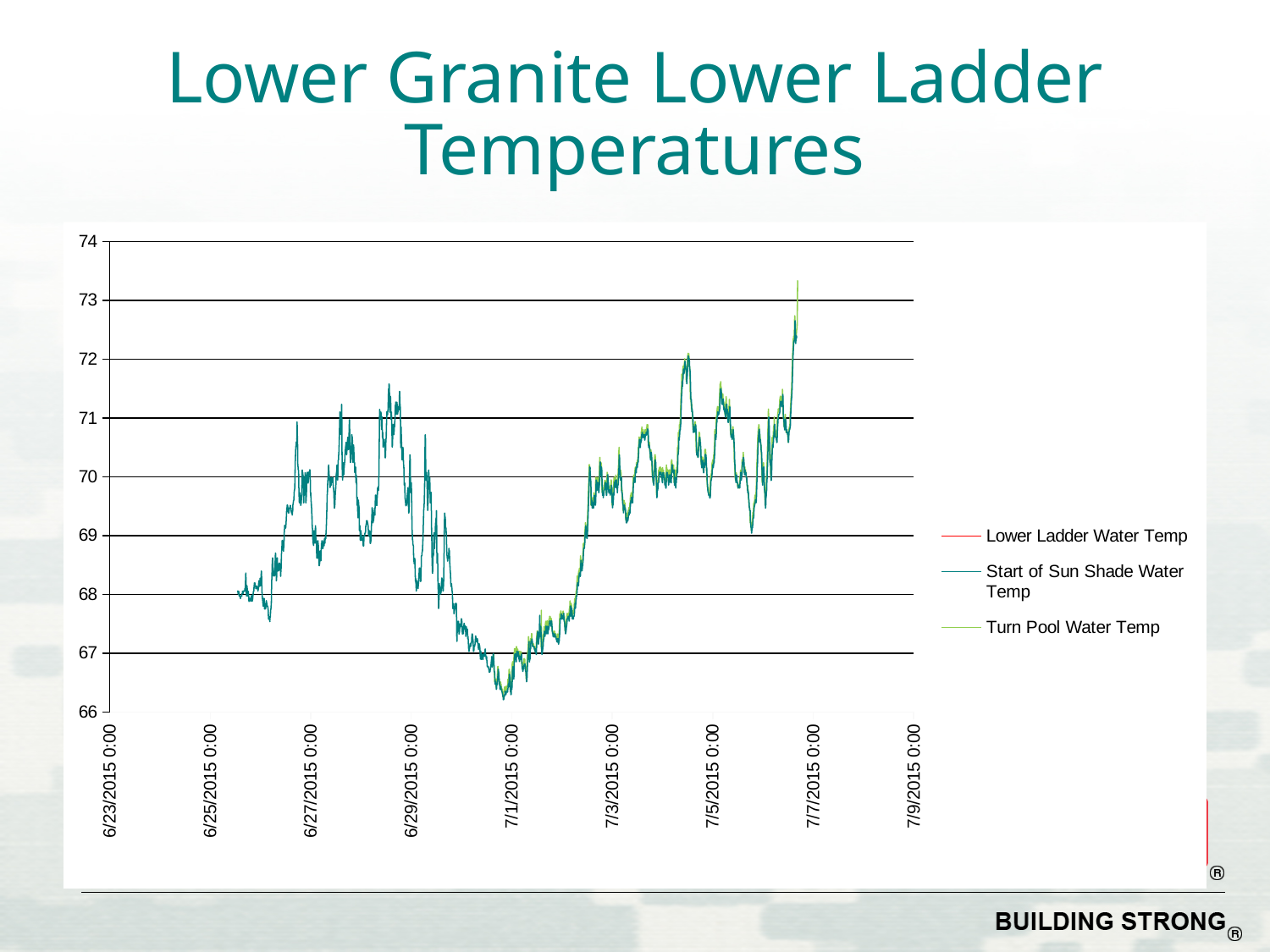
What is the title of the slide's chart? Lower Granite Lower Ladder Temperatures Do the temperature values rise or fall between 7/1/2015 and 7/3/2015? rise Is the highest value of the Lower Ladder Water Temp series, reached just before 7/7/2015, greater or less than 72? greater What is the maximum value shown on the y axis? 74 How many series does the legend list? 3 What is the name of the third series listed in the legend? Turn Pool Water Temp Which is larger for the Lower Ladder Water Temp series: the value around 7/1/2015 or the value around 7/5/2015? 7/5/2015 What kind of chart is shown on the slide? line chart Do the temperature values rise or fall between 6/29/2015 and 7/1/2015? fall Is the lowest value of the Lower Ladder Water Temp series, reached around 7/1/2015, greater or less than 67? less How many date labels are shown on the x axis? 9